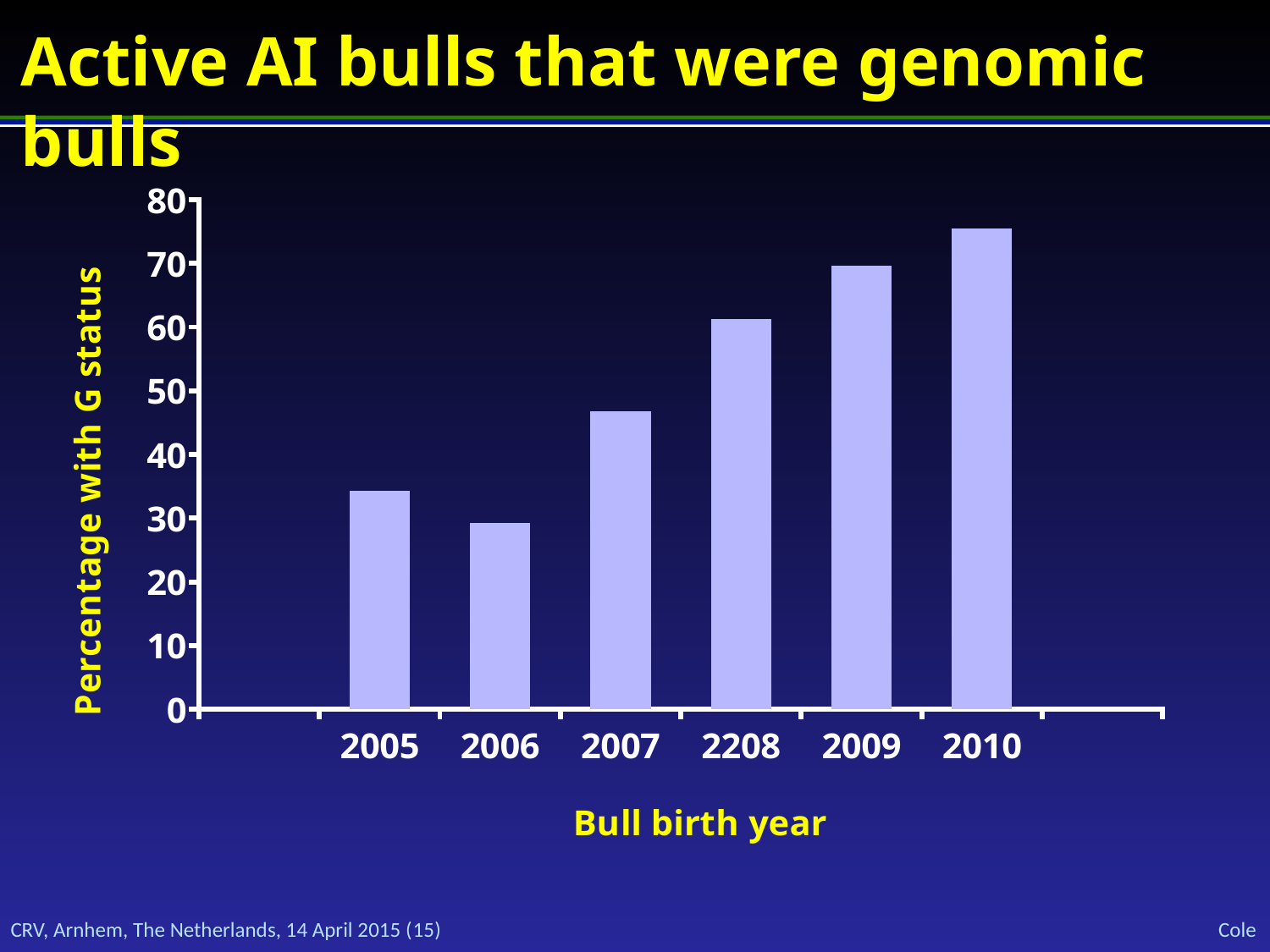
Which has a higher percentage with G status, bull birth year 2009 or 2006? 2009 How many bull birth years are plotted in the chart? 6 What is the label of the horizontal axis? Bull birth year Is the value for bull birth year 2010 greater or less than 70? greater What kind of chart is shown on the slide? bar chart Which has a higher percentage with G status, bull birth year 2005 or 2007? 2007 Is the value for bull birth year 2007 greater or less than 50? less What is the label of the vertical axis? Percentage with G status Is the value for bull birth year 2006 greater or less than 40? less Which bull birth year has the lowest percentage with G status? 2006 Which bull birth year has the highest percentage with G status? 2010